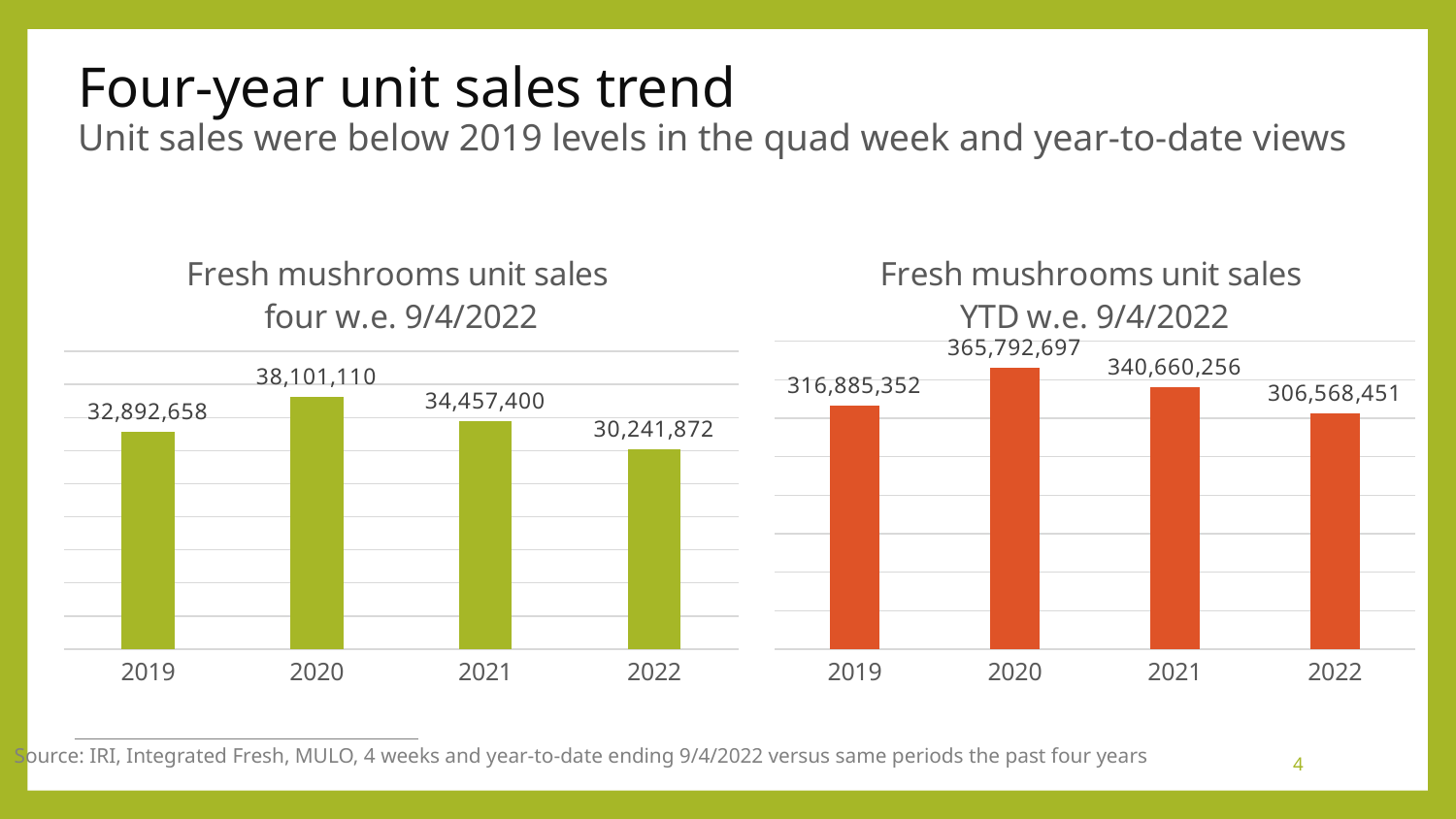
In the 'Fresh mushrooms unit sales YTD w.e. 9/4/2022' chart, which is larger, the value for 2019 or the value for 2021? 2021 What colour are the bars in the 'Fresh mushrooms unit sales four w.e. 9/4/2022' chart? Green In the 'Fresh mushrooms unit sales four w.e. 9/4/2022' chart, what is the value for 2020? 38,101,110 In the 'Fresh mushrooms unit sales YTD w.e. 9/4/2022' chart, what is the difference between the 2020 and 2022 values? 59,224,246 In the 'Fresh mushrooms unit sales four w.e. 9/4/2022' chart, which year has the highest value? 2020 In the 'Fresh mushrooms unit sales YTD w.e. 9/4/2022' chart, which year has the lowest value? 2022 What kind of chart is the 'Fresh mushrooms unit sales YTD w.e. 9/4/2022' chart? Bar chart In the 'Fresh mushrooms unit sales four w.e. 9/4/2022' chart, which is larger, the value for 2021 or the value for 2022? 2021 In the 'Fresh mushrooms unit sales four w.e. 9/4/2022' chart, what is the difference between the 2020 and 2019 values? 5,208,452 In the 'Fresh mushrooms unit sales YTD w.e. 9/4/2022' chart, what is the value for 2022? 306,568,451 In the 'Fresh mushrooms unit sales YTD w.e. 9/4/2022' chart, do the values rise or fall from 2020 to 2022? Fall How many years are shown in the 'Fresh mushrooms unit sales four w.e. 9/4/2022' chart? 4